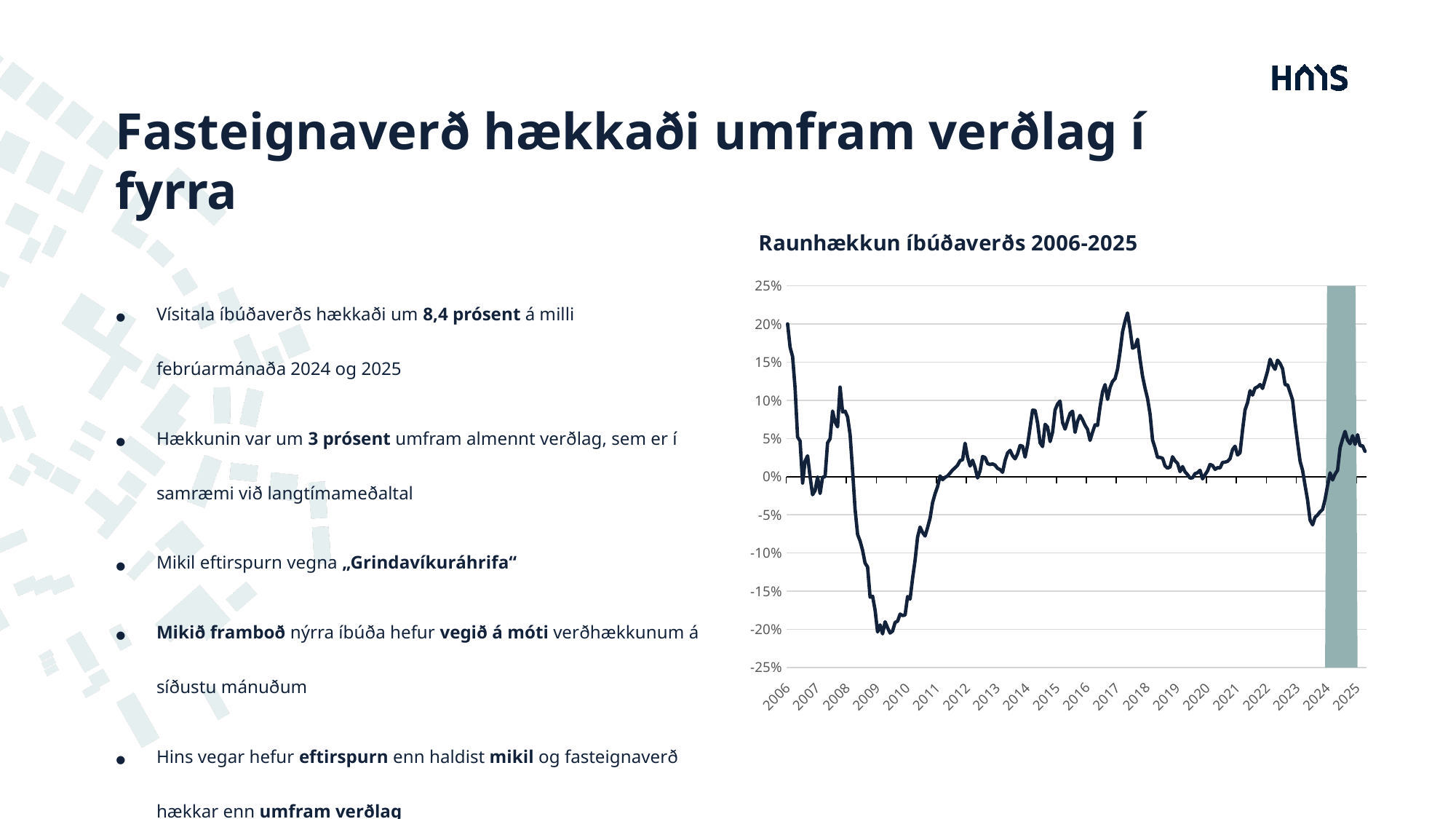
Is the lowest value reached on the chart (around 2009-2010) greater or less than -15%? less Is the value at the end of the series in 2025 greater or less than 0%? greater Is the value at the start of 2023 greater or less than 0%? greater Which peak is higher: the one around 2017 or the one around 2022? 2017 What are the lowest and highest values shown on the chart's vertical axis? -25% and 25% How many year labels are shown on the chart's horizontal axis? 20 Does the line rise or fall between the start of 2006 and 2009? fall What is the title of the chart? Raunhækkun íbúðaverðs 2006-2025 What kind of chart is shown on the slide? line chart Does the line rise or fall between 2010 and 2012? rise